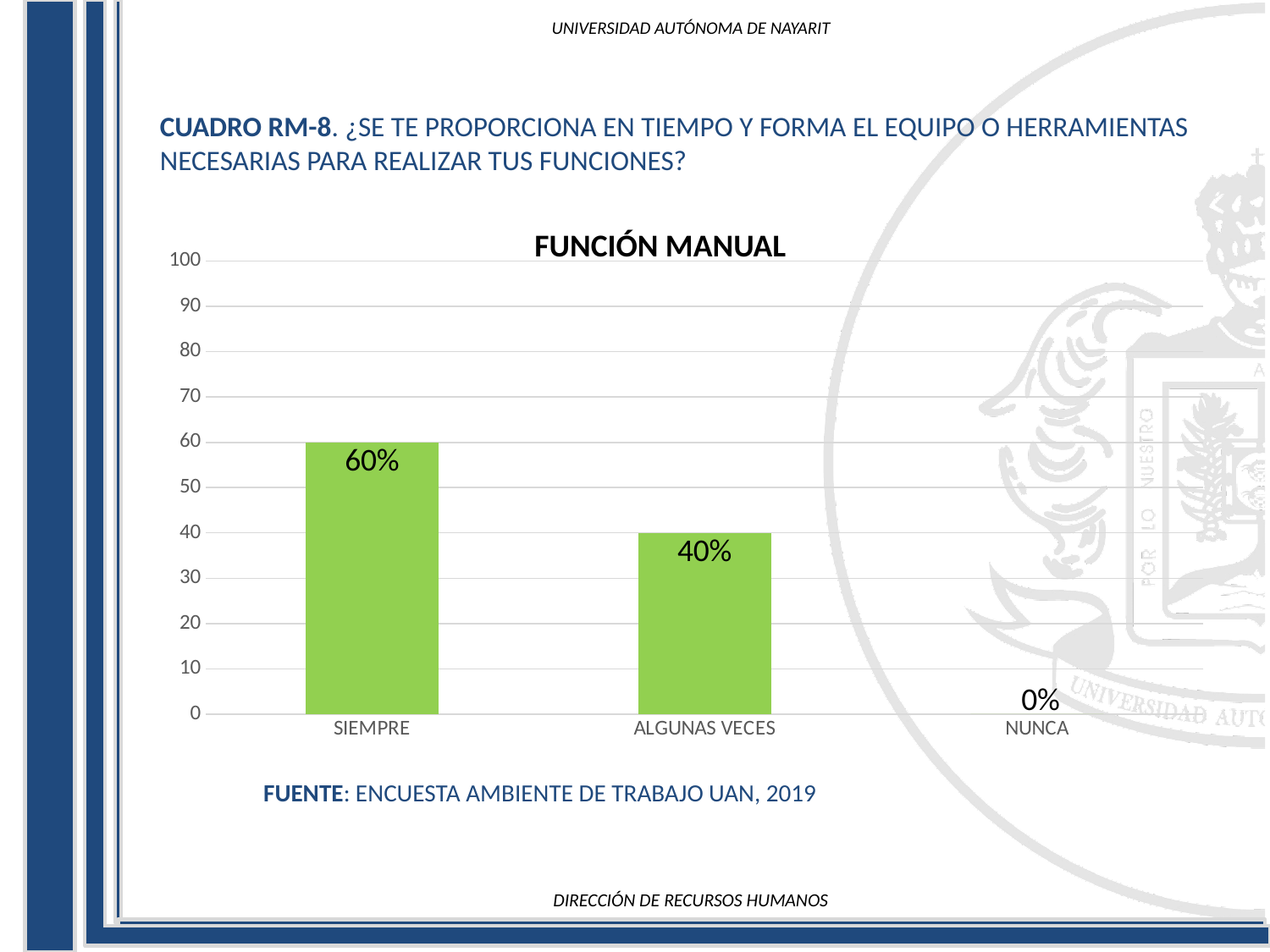
Which category has the highest value? SIEMPRE What is the value for SIEMPRE? 60% Which category has the lowest value? NUNCA What kind of chart is shown on the slide? bar chart Which is larger, the value for SIEMPRE or the value for ALGUNAS VECES? SIEMPRE What is the title of the chart? FUNCIÓN MANUAL Is the value for ALGUNAS VECES greater or less than 50? less How many categories are shown on the x axis? 3 What is the value for NUNCA? 0% What is the value for ALGUNAS VECES? 40% What is the difference between the values for SIEMPRE and ALGUNAS VECES? 20% Do the values rise or fall from left to right along the x axis? fall